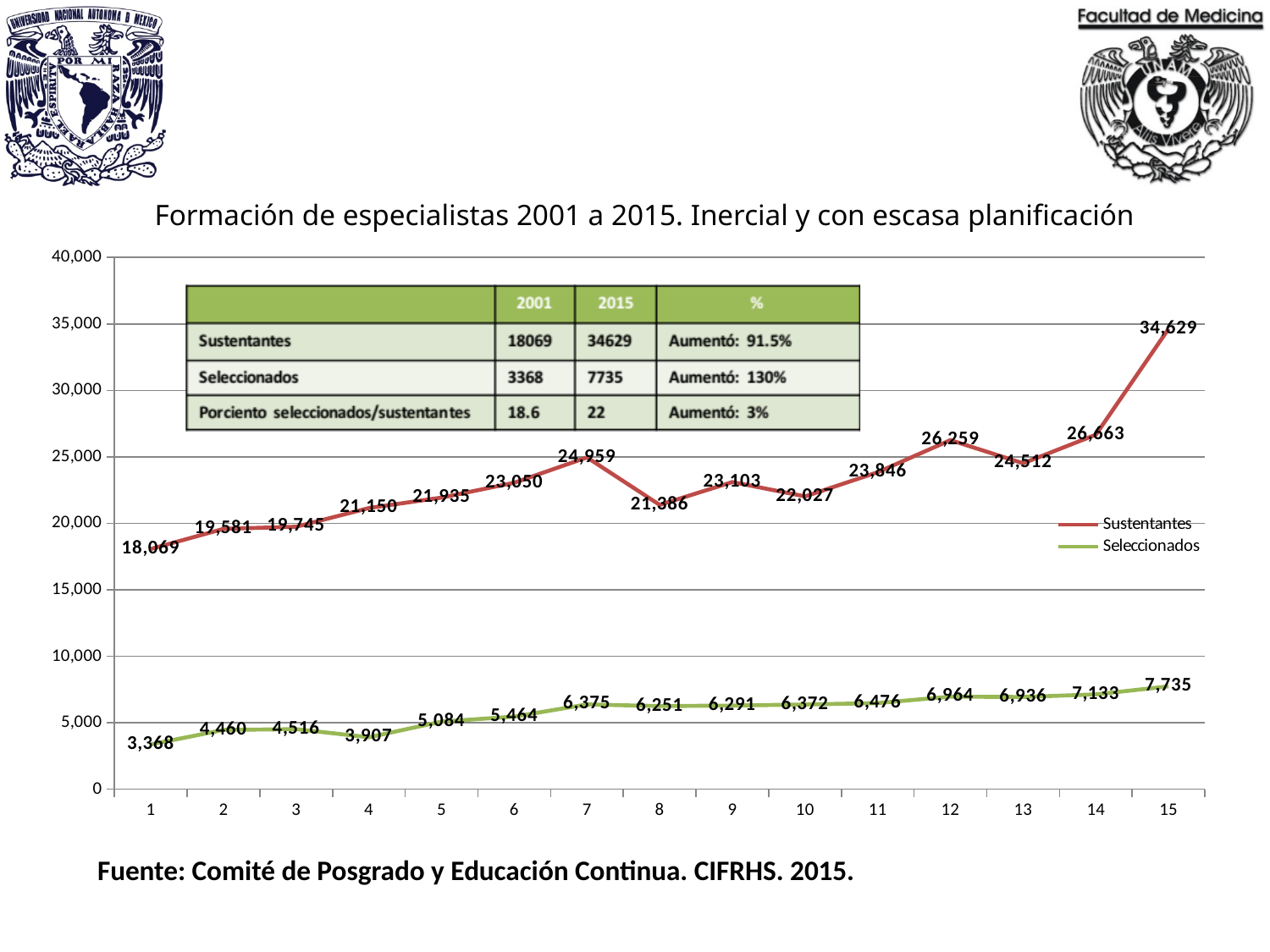
Is the value of Sustentantes at point 12 greater or less than 25,000? greater What is the value of Sustentantes at point 7? 24,959 Which series is drawn in red? Sustentantes At which x-axis point is the Seleccionados series lowest? 1 What is the value of Seleccionados at point 1? 3,368 How many series does the chart legend list? 2 What is the difference between Sustentantes at point 15 and at point 1? 16,560 What type of chart is shown on the slide? line chart What is the value of Sustentantes at point 15? 34,629 Which is larger: Seleccionados at point 4 or Seleccionados at point 5? Seleccionados at point 5 At which x-axis point is the Sustentantes series highest? 15 How many points are plotted along the x axis for each series? 15